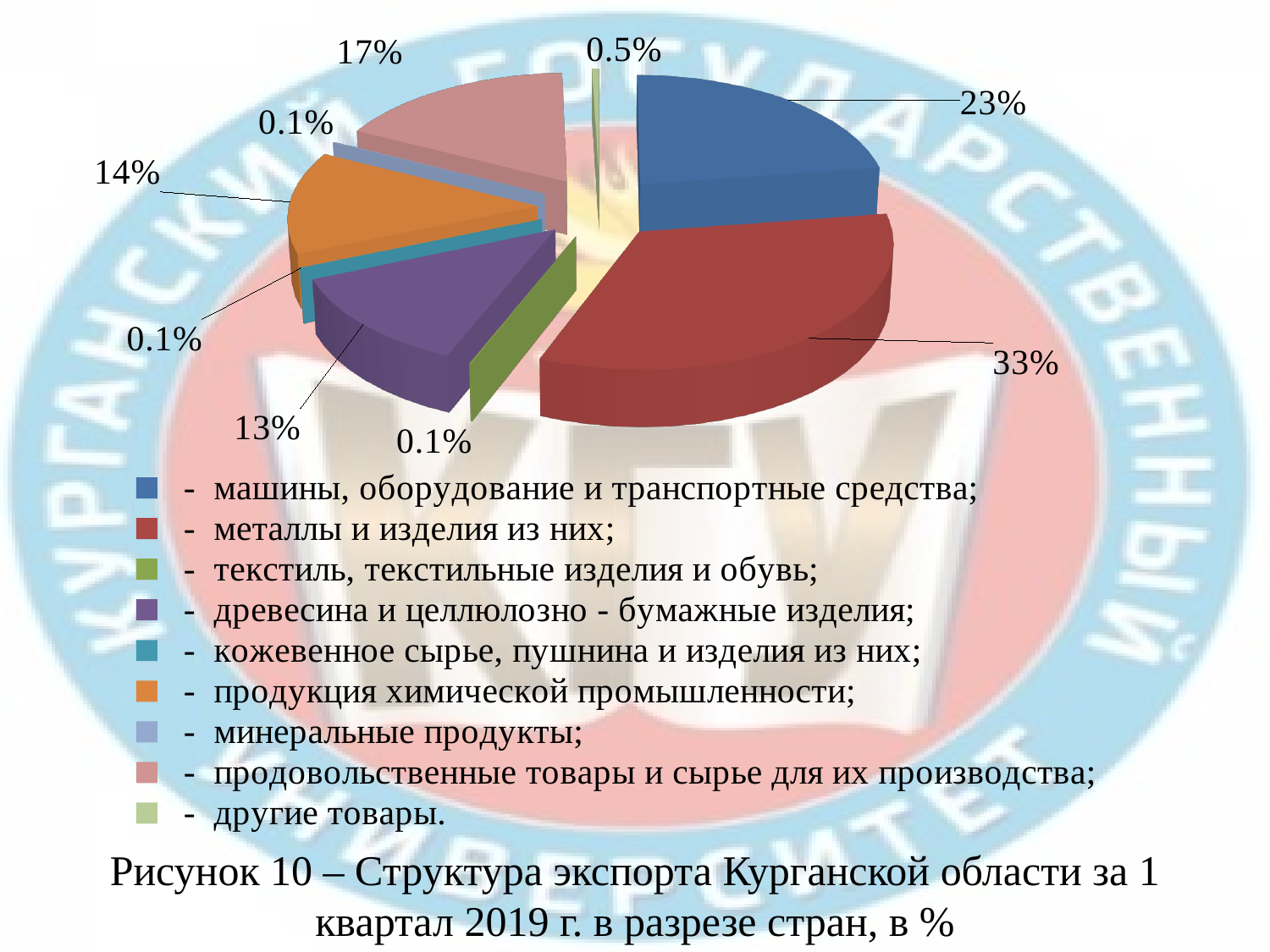
Which category has the largest share of the pie? металлы и изделия из них Which is larger: the share for 'продовольственные товары и сырье для их производства' or for 'продукция химической промышленности'? продовольственные товары и сырье для их производства How many slices does the pie chart have? 9 What type of chart is shown on the slide? Pie chart What is the difference in percentage points between 'металлы и изделия из них' and 'машины, оборудование и транспортные средства'? 10 What is the value for 'продукция химической промышленности'? 14% What colour is the slice for 'металлы и изделия из них'? Red What is the value for 'древесина и целлюлозно - бумажные изделия'? 13% What is the value for 'другие товары'? 0.5% What is the value for 'машины, оборудование и транспортные средства'? 23% What is the value for 'продовольственные товары и сырье для их производства'? 17% What share of the pie does 'металлы и изделия из них' have? 33%